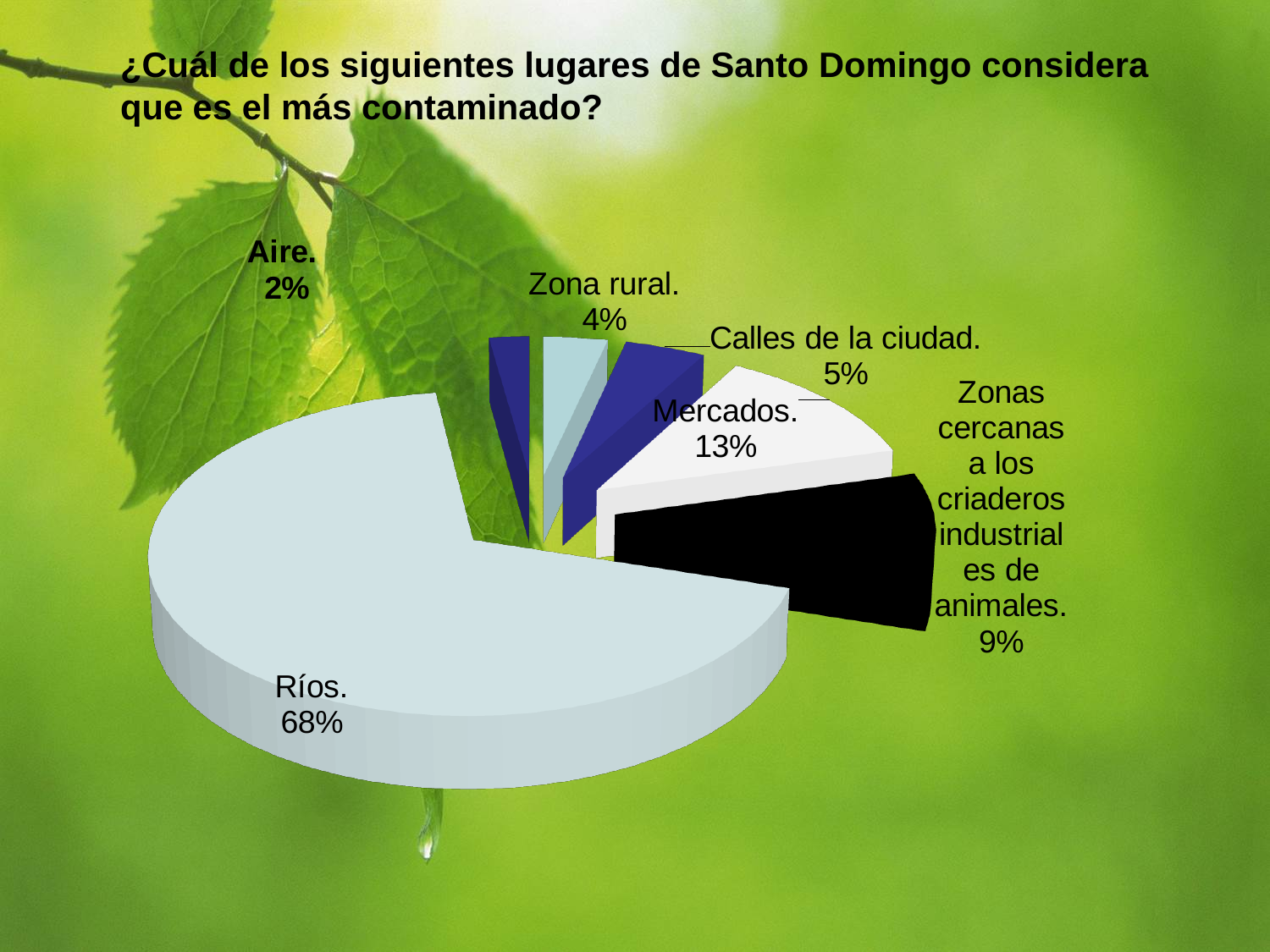
Which category has the smallest share of the pie? Aire What percentage of the pie is labelled "Ríos"? 68% What kind of chart is shown on the slide? pie chart What percentage is shown for "Zona rural"? 4% What question does the chart title ask? ¿Cuál de los siguientes lugares de Santo Domingo considera que es el más contaminado? What percentage is shown for "Calles de la ciudad"? 5% What percentage is shown for "Aire"? 2% Which category has the largest share of the pie? Ríos Which is larger, the share for "Mercados" or the share for "Zonas cercanas a los criaderos industriales de animales"? Mercados What is the difference in percentage points between "Ríos" and "Mercados"? 55 How many slices does the pie chart have? 6 What percentage is shown for "Mercados"? 13%